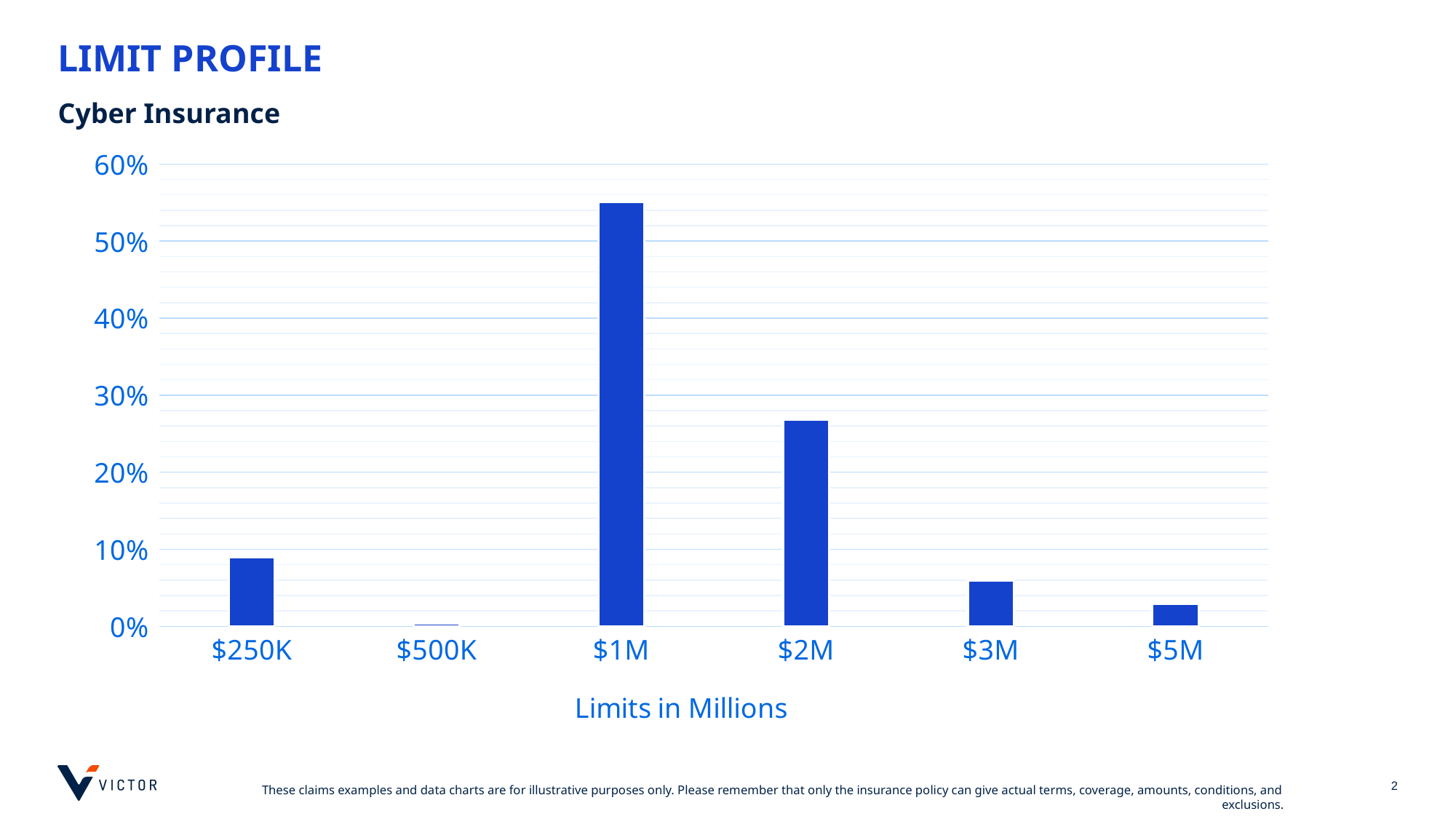
Is the value for $250K greater or less than 10%? less What kind of chart is shown on the slide? bar chart Is the value for $5M greater or less than 10%? less Is the value for $2M greater or less than 30%? less What is the title of the x axis? Limits in Millions Which limit has the highest percentage? $1M Which is larger, the value for $2M or the value for $250K? $2M Which is larger, the value for $3M or the value for $5M? $3M Which limit has the lowest percentage? $500K How many limit categories are shown on the x axis? 6